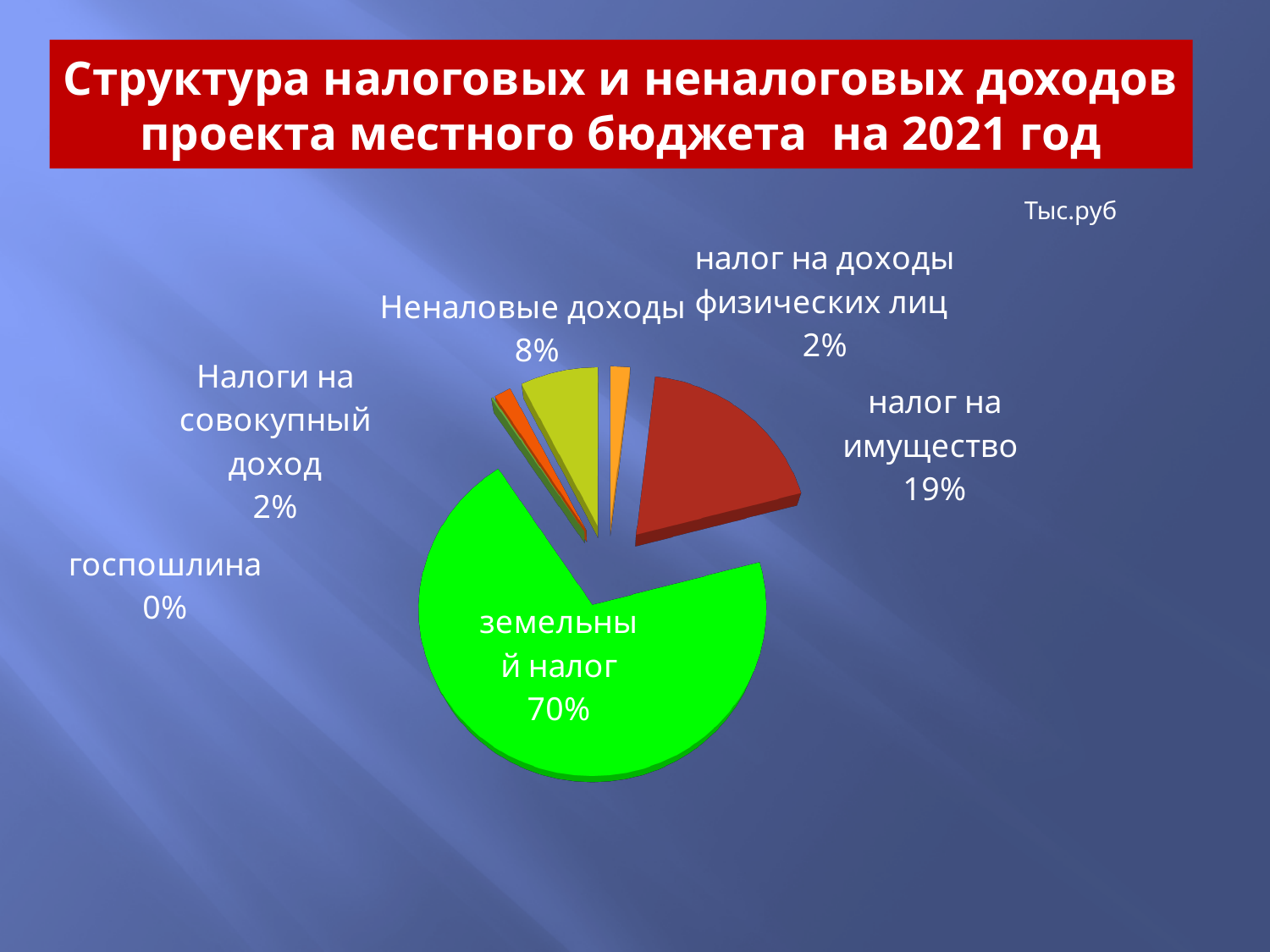
What kind of chart is shown on the slide? pie chart What is the title of the slide containing the chart? Структура налоговых и неналоговых доходов проекта местного бюджета на 2021 год What is the difference in percentage points between земельный налог and налог на имущество? 51 Which category has the smallest slice of the pie? госпошлина What share of the pie does земельный налог account for? 70% What share of the pie does Неналовые доходы account for? 8% What share of the pie does налог на доходы физических лиц account for? 2% Which is larger, the share for налог на имущество or the share for Неналовые доходы? налог на имущество Which category has the largest slice of the pie? земельный налог How many categories are shown in the pie chart? 6